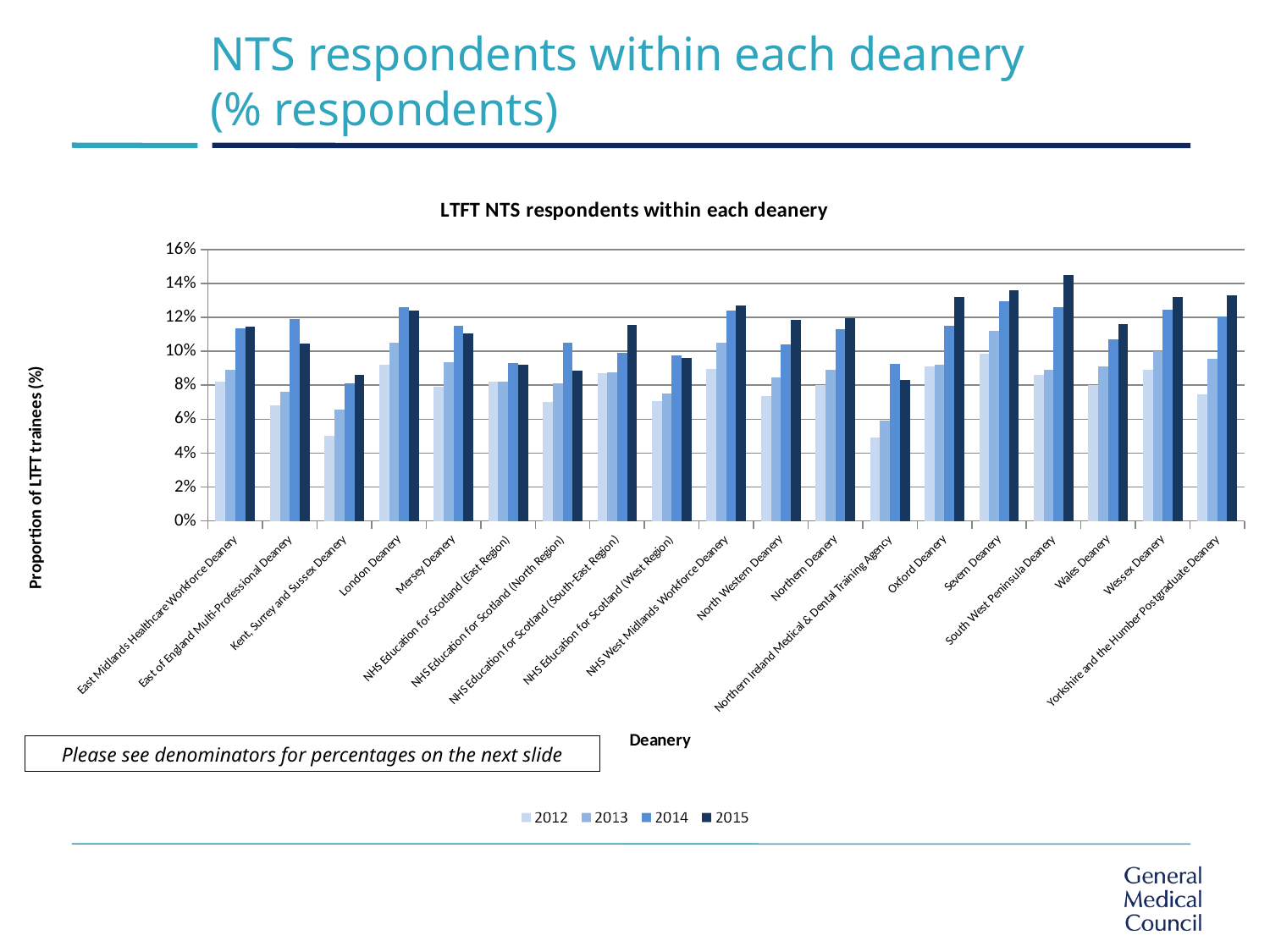
Do the values for Kent, Surrey and Sussex Deanery rise or fall from 2012 to 2015? Rise Which is larger, the 2015 value for London Deanery or the 2015 value for Kent, Surrey and Sussex Deanery? London Deanery What kind of chart is shown on the slide? Bar chart How many deaneries are shown on the x axis? 19 What is the title of the chart? LTFT NTS respondents within each deanery Is the 2015 value for South West Peninsula Deanery greater or less than 14%? greater Is the 2014 value for London Deanery greater or less than 12%? greater Is the 2015 value for Oxford Deanery greater or less than 12%? greater Which deanery has the highest value for 2015? South West Peninsula Deanery How many series does the legend list? 4